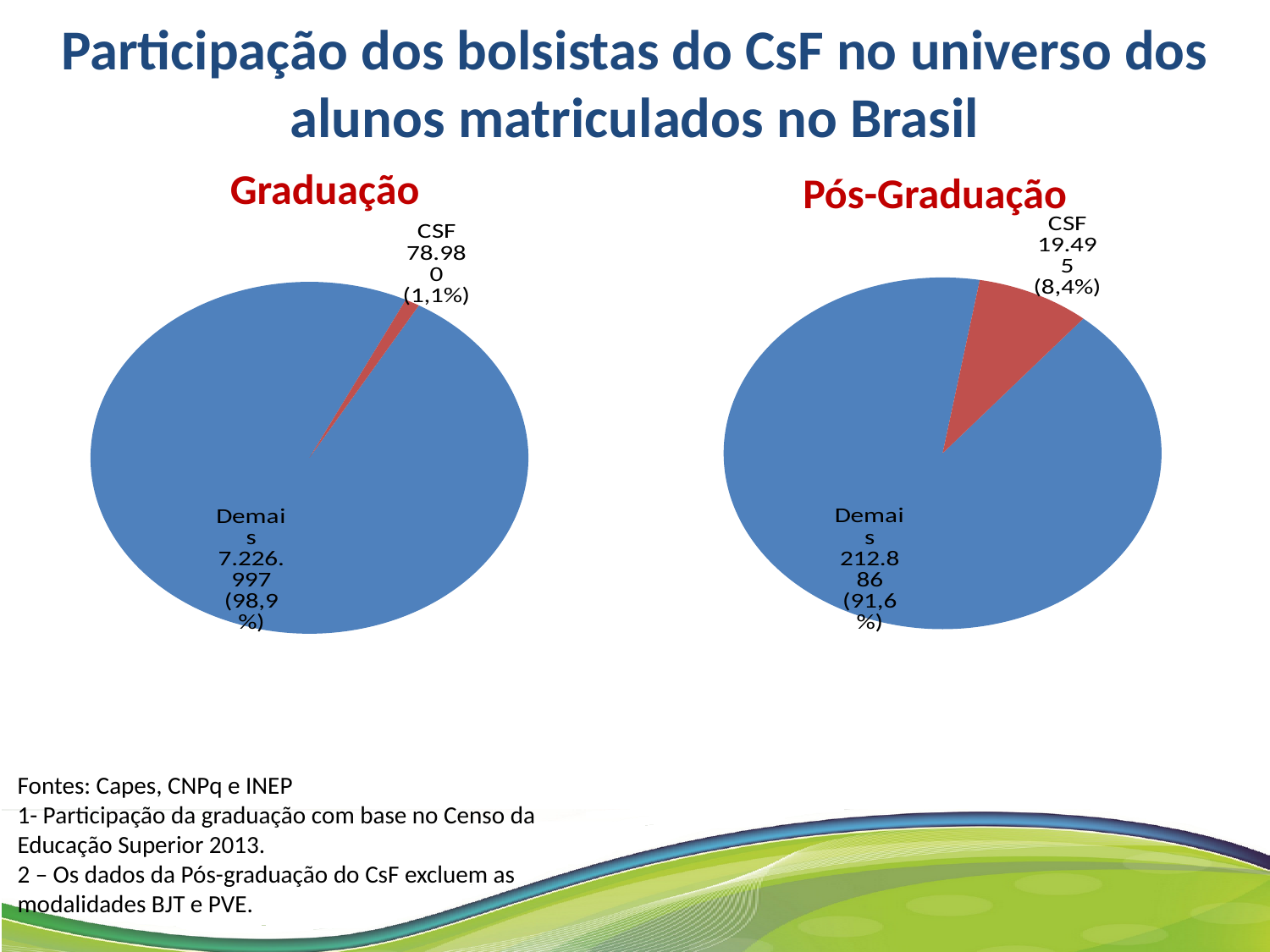
What kind of chart is the Graduação chart? Pie chart In the Pós-Graduação chart, which slice is the smallest? CSF In the Pós-Graduação chart, what value is shown for Demais? 212.886 Which chart has the larger CSF share, Graduação or Pós-Graduação? Pós-Graduação In the Pós-Graduação chart, what share of the pie does CSF represent? 8,4% In the Pós-Graduação chart, what share of the pie does Demais represent? 91,6% In the Graduação chart, which slice is the largest? Demais In the Pós-Graduação chart, what value is shown for CSF? 19.495 In the Graduação chart, what share of the pie does CSF represent? 1,1% In the Graduação chart, what value is shown for Demais? 7.226.997 How many slices does the Pós-Graduação chart have? 2 In the Graduação chart, what value is shown for CSF? 78.980